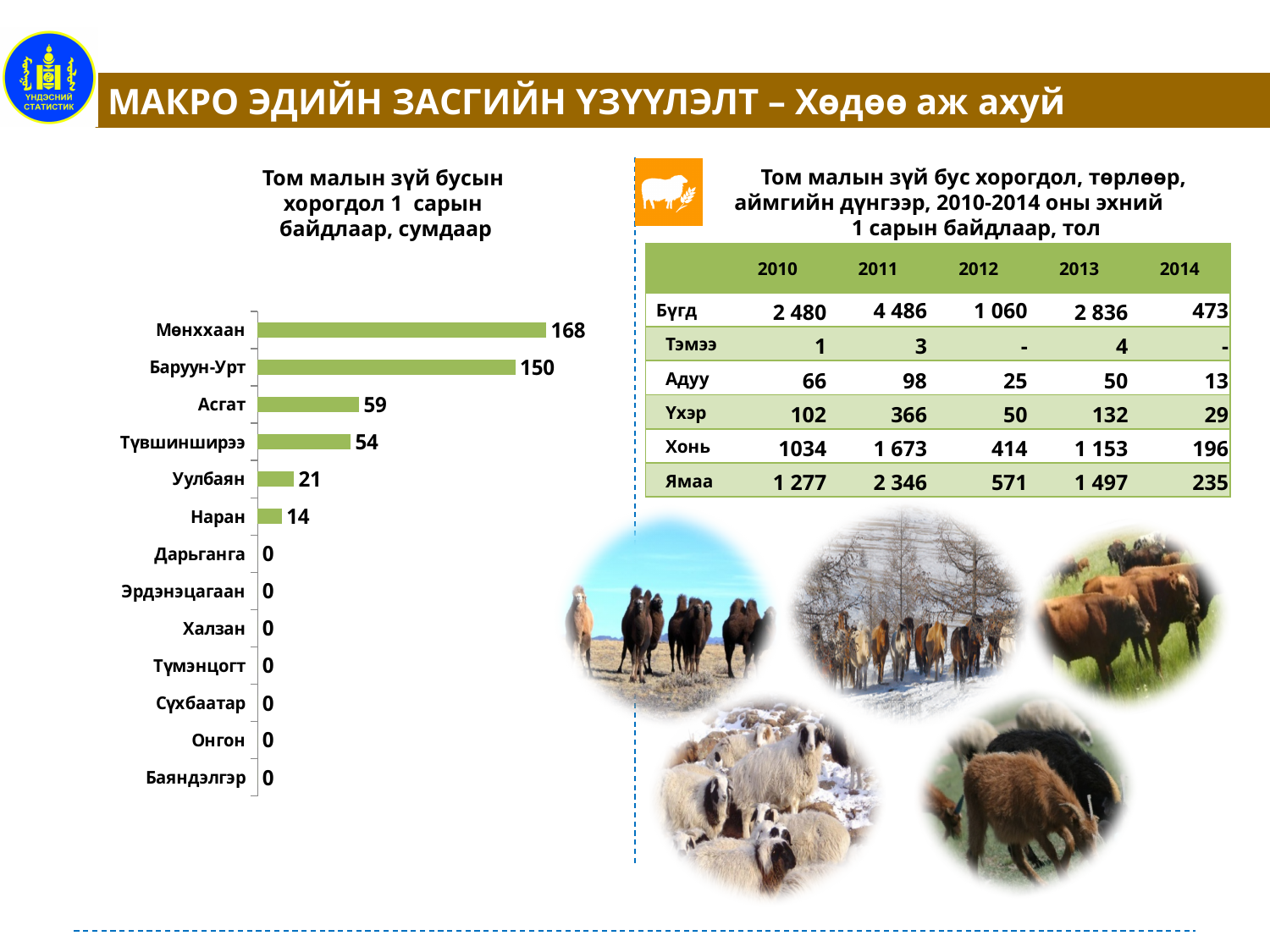
How many categories in the bar chart have a value of 0? 7 What is the value for Баруун-Урт in the bar chart? 150 Which is larger in the bar chart, the value for Уулбаян or the value for Наран? Уулбаян What is the value for Наран in the bar chart? 14 What is the difference between the values for Асгат and Уулбаян? 38 Which category has the highest value in the bar chart? Мөнххаан What type of chart is shown on the slide? bar chart What is the value for Мөнххаан in the bar chart? 168 What is the value for Түвшинширээ in the bar chart? 54 How many categories are shown in the bar chart? 13 What is the value for Асгат in the bar chart? 59 What is the difference between the values for Мөнххаан and Баруун-Урт? 18